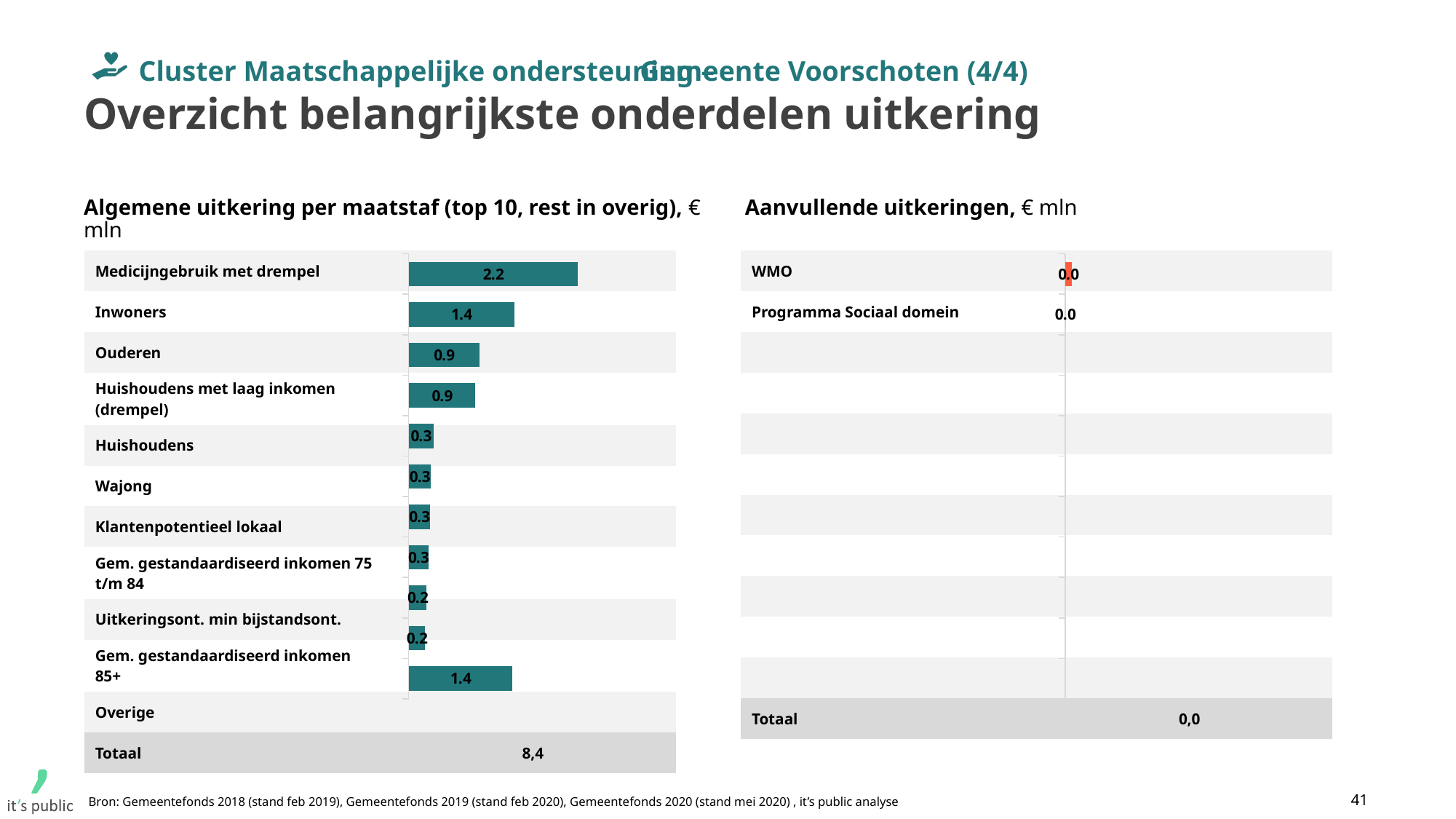
In the chart 'Algemene uitkering per maatstaf', which category has the highest value? Medicijngebruik met drempel In the chart 'Algemene uitkering per maatstaf', what is the Totaal value shown? 8,4 In the chart 'Algemene uitkering per maatstaf', what is the value for Ouderen? 0.9 In the chart 'Algemene uitkering per maatstaf', which is larger: Ouderen or Huishoudens? Ouderen In the chart 'Algemene uitkering per maatstaf', what is the value for Inwoners? 1.4 In the chart 'Algemene uitkering per maatstaf', what is the value for Overige? 1.4 In the chart 'Algemene uitkering per maatstaf', what is the difference between Medicijngebruik met drempel and Inwoners? 0.8 In the chart 'Aanvullende uitkeringen', what is the value for WMO? 0.0 In the chart 'Algemene uitkering per maatstaf', how many categories are shown (excluding the Totaal row)? 11 In the chart 'Algemene uitkering per maatstaf', what is the value for Medicijngebruik met drempel? 2.2 What is the title of the chart on the right side of the slide? Aanvullende uitkeringen, € mln What kind of chart is 'Algemene uitkering per maatstaf'? Bar chart